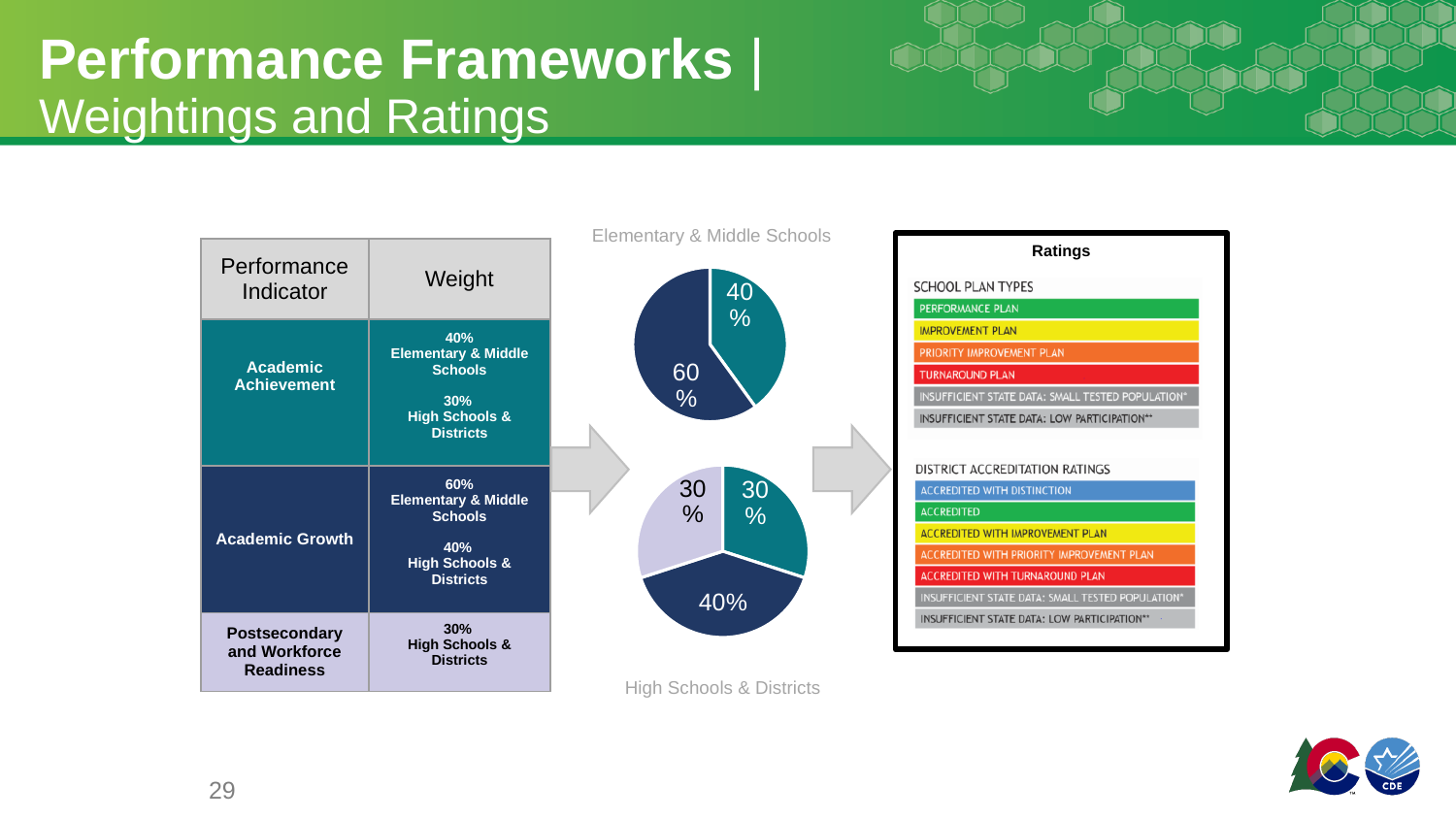
In the Elementary & Middle Schools pie chart, is the dark navy slice larger or smaller than the teal slice? larger In the High Schools & Districts pie chart, what is the value of the dark navy slice at the bottom? 40% In the High Schools & Districts pie chart, what is the difference between the largest slice and one of the 30% slices? 10% Which pie chart is labeled 'High Schools & Districts', the upper or the lower one? the lower one In the High Schools & Districts pie chart, what is the value of the largest slice? 40% In the Elementary & Middle Schools pie chart, what is the value of the largest slice? 60% In the High Schools & Districts pie chart, how many slices are labeled 30%? 2 In the Elementary & Middle Schools pie chart, what is the difference between the two slices? 20% How many slices does the Elementary & Middle Schools pie chart have? 2 What kind of chart is the Elementary & Middle Schools chart? pie chart How many slices does the High Schools & Districts pie chart have? 3 In the Elementary & Middle Schools pie chart, what is the value of the smallest slice? 40%